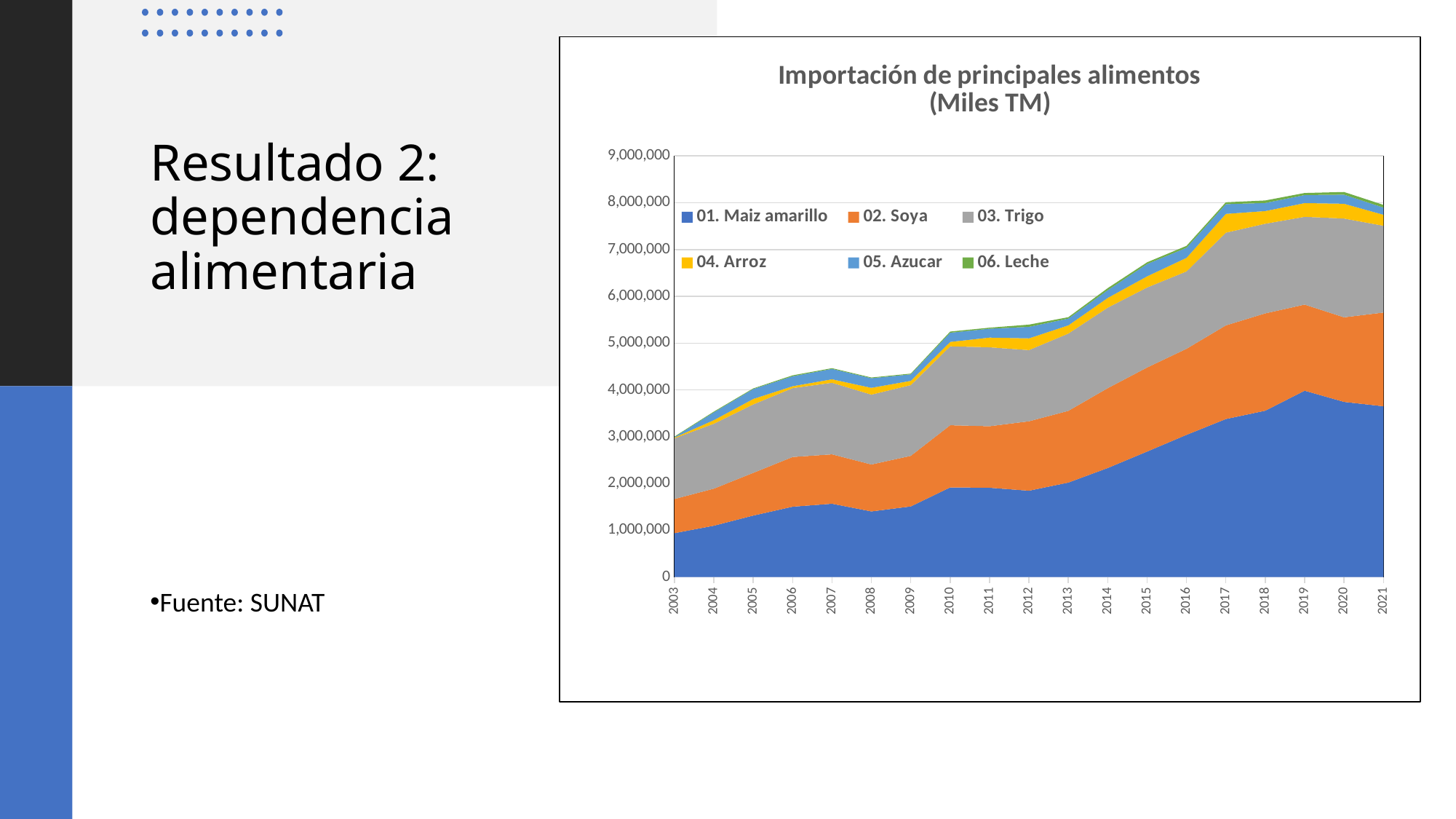
What is the last year shown on the x axis of the chart? 2021 How many years are shown along the x axis of the chart? 19 Is the total stacked value for 2010 greater or less than 5,000,000? greater Is the value for 01. Maiz amarillo in 2021 greater or less than 3,000,000? greater Is the total stacked value for 2015 greater or less than 6,000,000? greater Which colour represents 01. Maiz amarillo in the chart? Blue What is the title of the chart? Importación de principales alimentos (Miles TM) Does the total import volume generally rise or fall from 2003 to 2021? Rise What kind of chart is shown on the slide? Stacked area chart What is the first year shown on the x axis of the chart? 2003 In 2021, which is larger: 01. Maiz amarillo or 02. Soya? 01. Maiz amarillo How many series does the legend of the chart list? 6